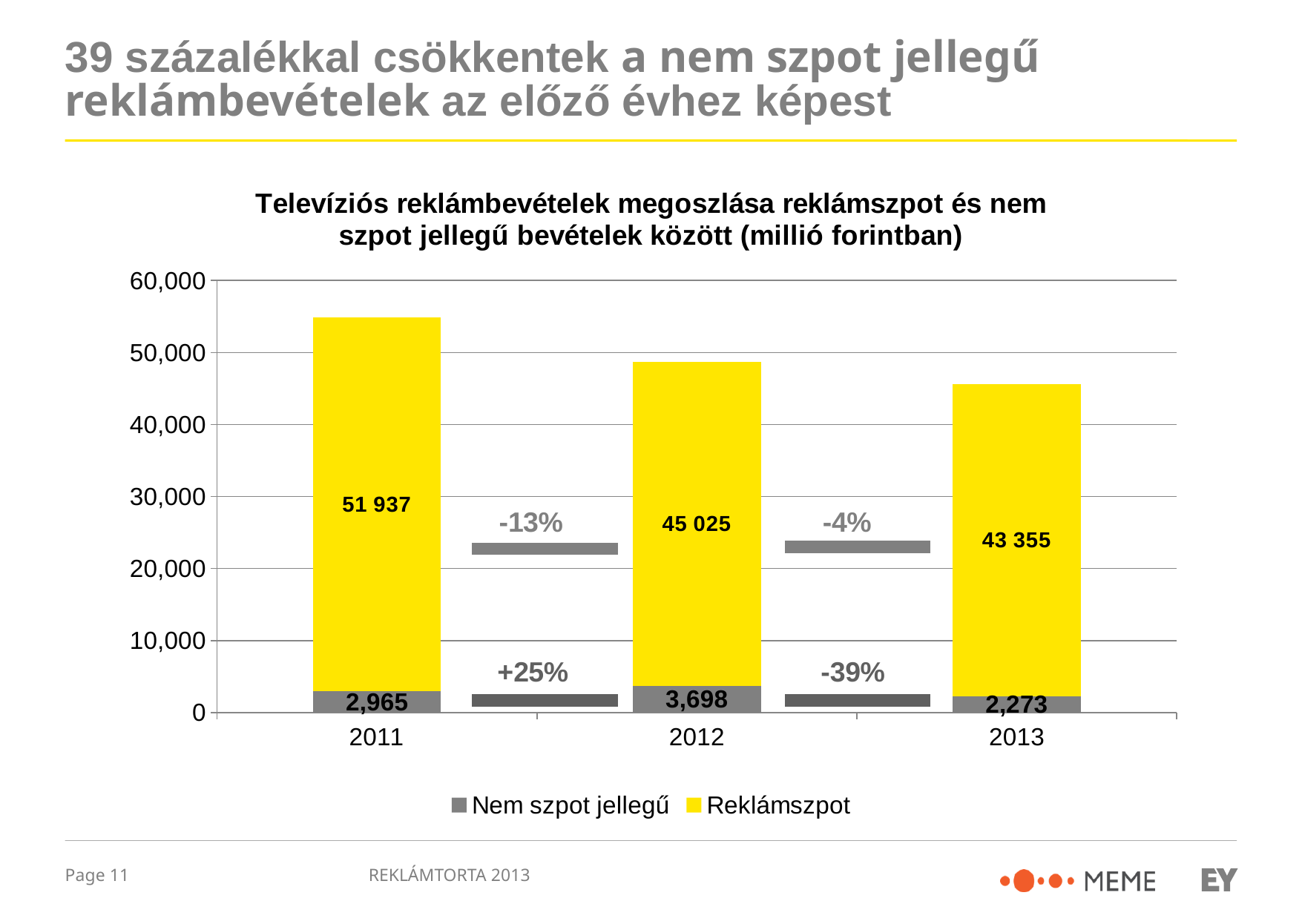
What is the Nem szpot jellegű value for 2012? 3,698 Is the Nem szpot jellegű value larger in 2011 or in 2013? 2011 Which year has the highest Nem szpot jellegű value? 2012 How many years are shown on the x axis? 3 Which year has the lowest Reklámszpot value? 2013 What is the Reklámszpot value for 2011? 51 937 What is the difference between the Reklámszpot values for 2011 and 2012? 6 912 Is the total stacked bar for 2012 greater or less than 50,000? less What kind of chart is shown on the slide? Stacked bar chart What is the total of the stacked bar for 2013? 45 628 What is the Reklámszpot value for 2013? 43 355 How many series does the legend list? 2